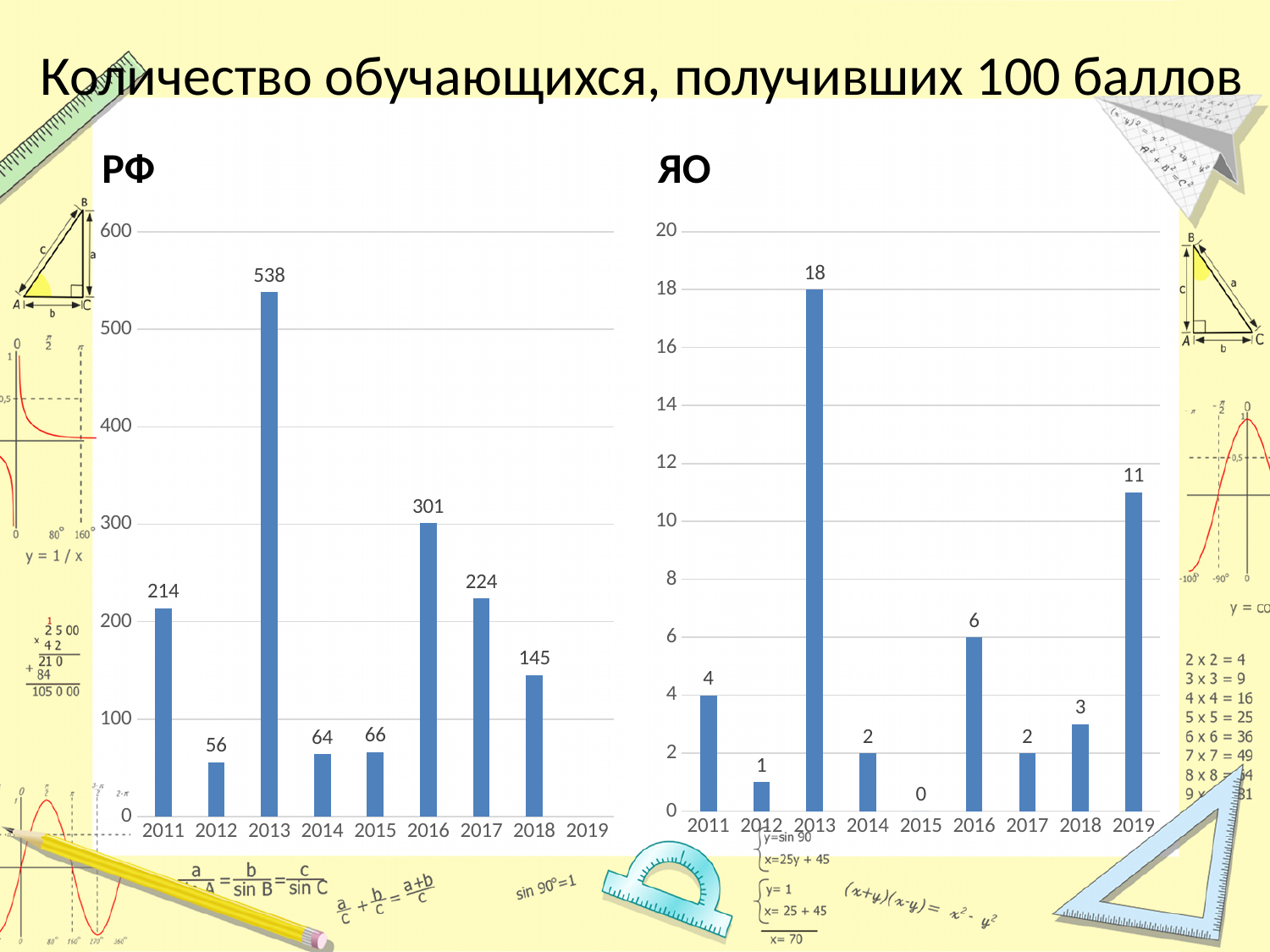
What kind of chart is the ЯО chart? bar chart In the ЯО chart, what is the value for 2019? 11 In the ЯО chart, which year has the lowest value? 2015 In the ЯО chart, what is the value for 2015? 0 In the РФ chart, what is the value for 2013? 538 In the ЯО chart, what is the difference between the values for 2013 and 2019? 7 In the РФ chart, which year has the highest value? 2013 In the ЯО chart, is the value for 2016 greater or less than 4? greater In the РФ chart, what is the value for 2018? 145 In the РФ chart, which is larger, the value for 2014 or the value for 2015? 2015 In the РФ chart, what is the difference between the values for 2016 and 2017? 77 In the РФ chart, do the values rise or fall from 2016 to 2018? fall